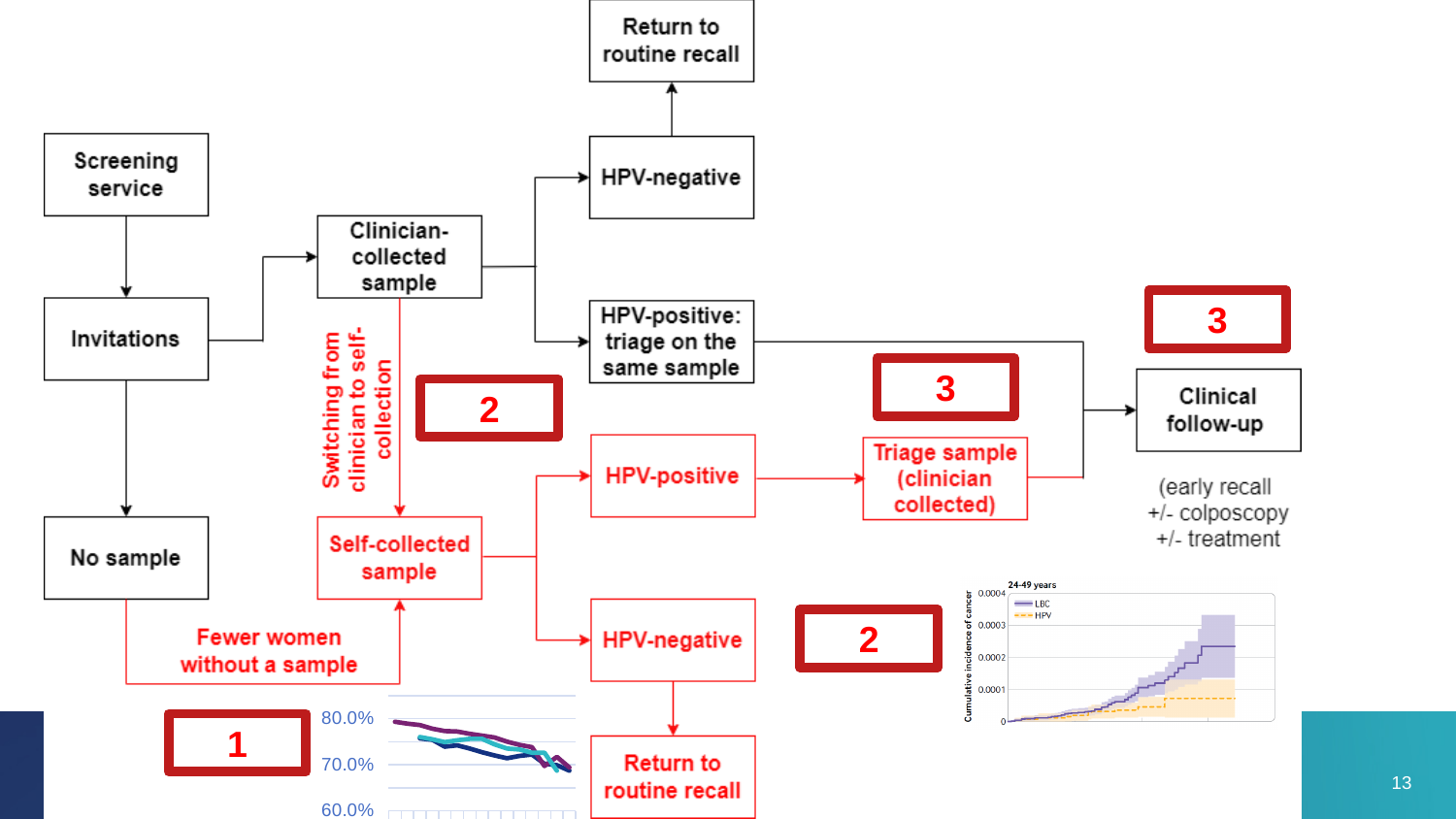
What is the title of the chart at the bottom right of the slide? 24-49 years What kind of chart is the small chart at the bottom left of the slide? line chart In the chart titled '24-49 years', which series reaches the higher cumulative incidence of cancer at the right end of the x axis, LBC or HPV? LBC What kind of chart is the chart at the bottom right of the slide titled '24-49 years'? line chart In the chart titled '24-49 years', do the values rise or fall along the x axis? rise In the chart titled '24-49 years', is the final value of the HPV series greater or less than 0.0001? less In the small line chart at the bottom left of the slide, is the starting value of the purple line greater or less than 70.0%? greater In the small line chart at the bottom left of the slide, is the final value of the teal line greater or less than 80.0%? less In the small line chart at the bottom left of the slide, do the lines rise or fall along the x axis? fall In the chart titled '24-49 years', how many series does the legend list? 2 What is the y-axis label of the chart titled '24-49 years'? Cumulative incidence of cancer